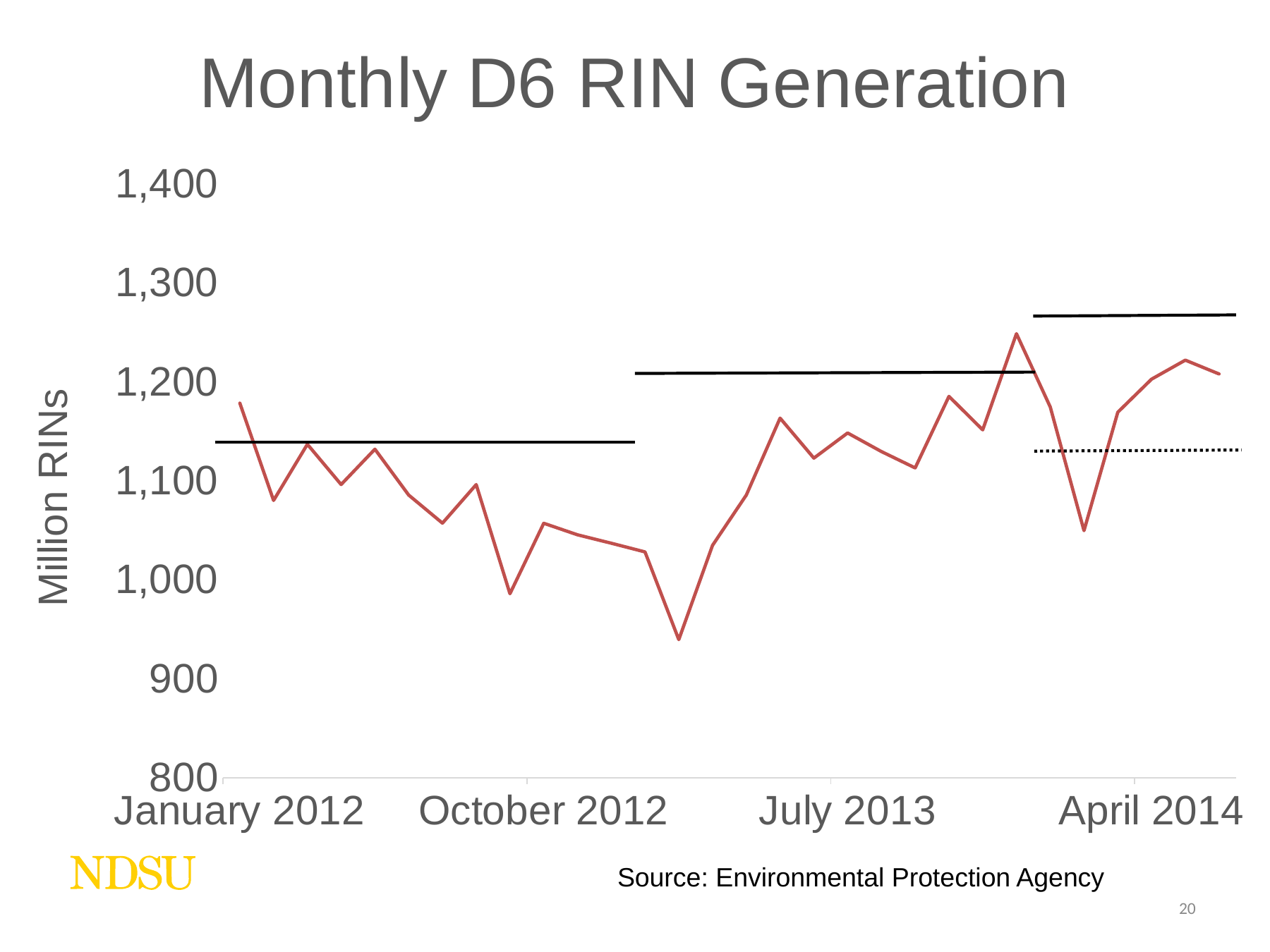
What is the label on the vertical axis of the chart? Million RINs How many date labels are shown on the horizontal axis? 4 What kind of chart is shown on the slide? line chart Is the value for October 2012 greater or less than 1,100? less Is the value for January 2012 greater or less than 1,100? greater Does the line generally rise or fall between January 2012 and October 2012? fall Is the lowest point on the line greater or less than 1,000? less What is the title of the chart? Monthly D6 RIN Generation